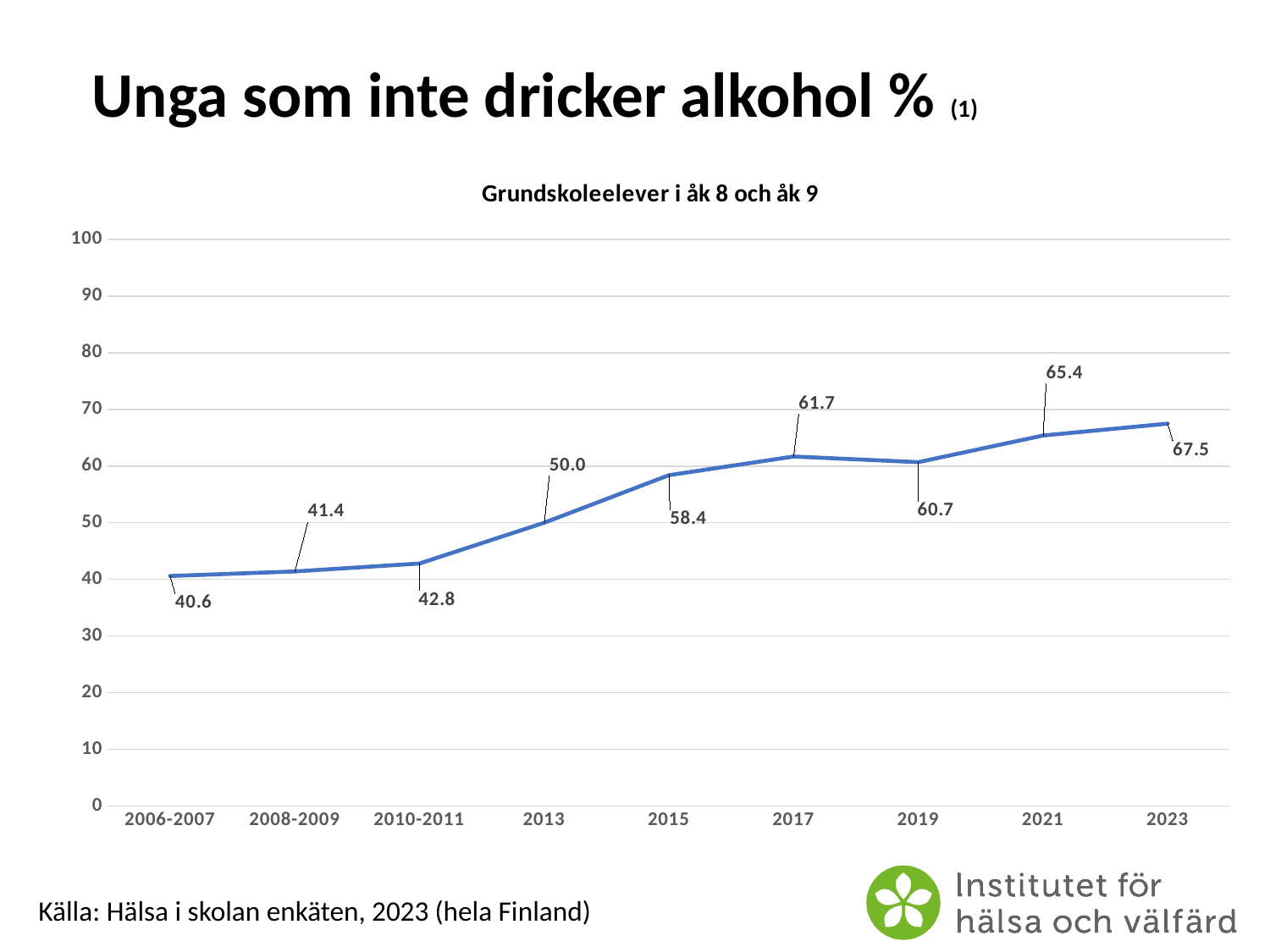
Which year has the highest value? 2023 What kind of chart is shown on the slide? line chart What is the value for 2013? 50.0 Which period has the lowest value? 2006-2007 Do the values generally rise or fall from 2006-2007 to 2023? rise What is the difference between the values for 2023 and 2006-2007? 26.9 How many data points are plotted on the chart? 9 What is the value for 2019? 60.7 What is the difference between the values for 2015 and 2013? 8.4 Is the value for 2021 greater or less than 60? greater Which is larger, the value for 2017 or the value for 2019? 2017 What is the value for 2006-2007? 40.6